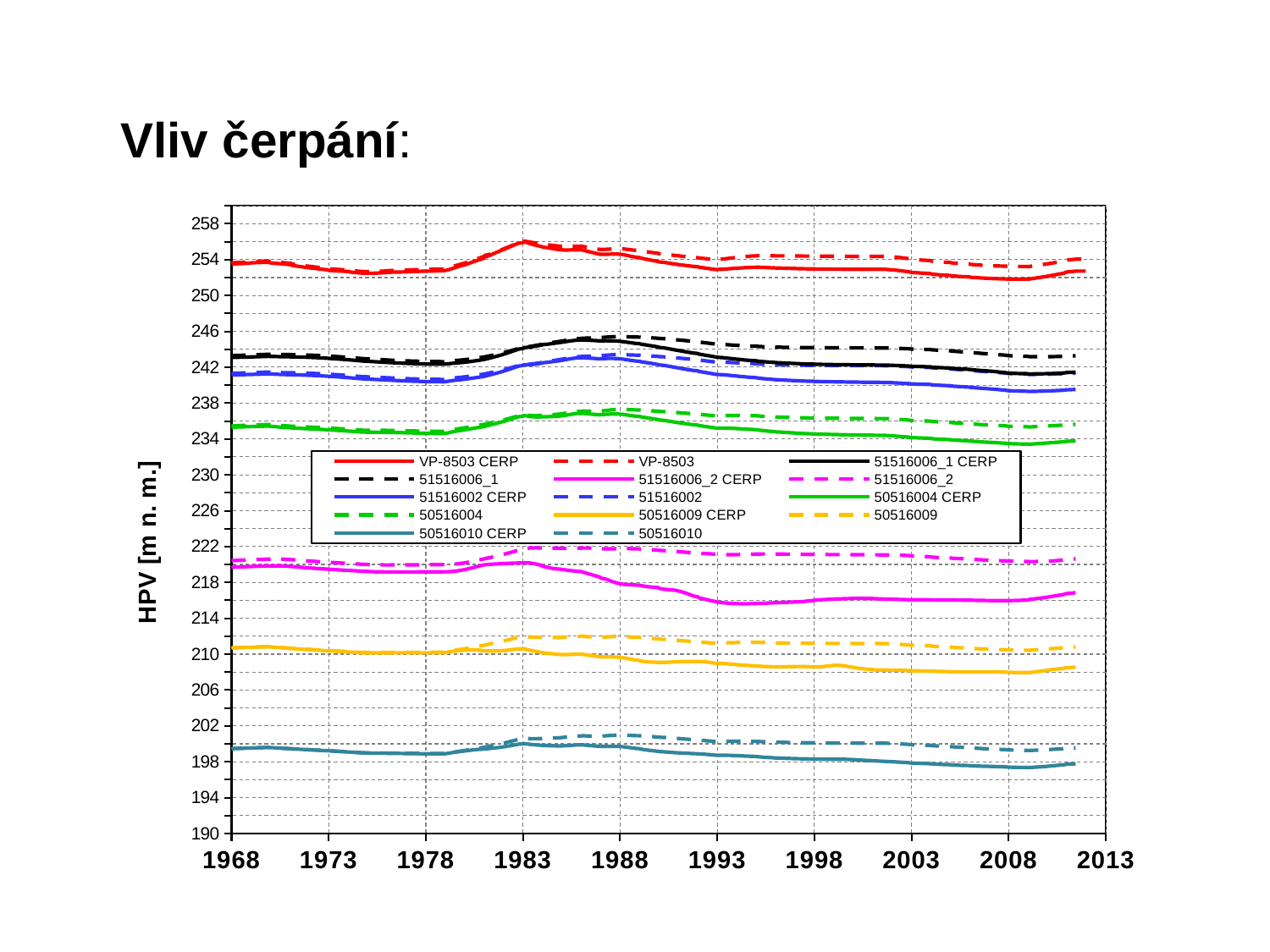
What is the title of the slide above the chart? Vliv čerpání: Is the value for 51516002 CERP in 2008 greater or less than 242? less In 2008, which is higher: 51516006_1 CERP or 51516006_1? 51516006_1 Is the value for 50516009 CERP in 2008 greater or less than 210? less Is the value for VP-8503 CERP in 1983 greater or less than 254? greater How many series does the legend list? 14 What is the label of the vertical axis? HPV [m n. m.] Does the 51516006_2 CERP series rise or fall between 1983 and 1993? fall What kind of chart is shown on the slide? line chart